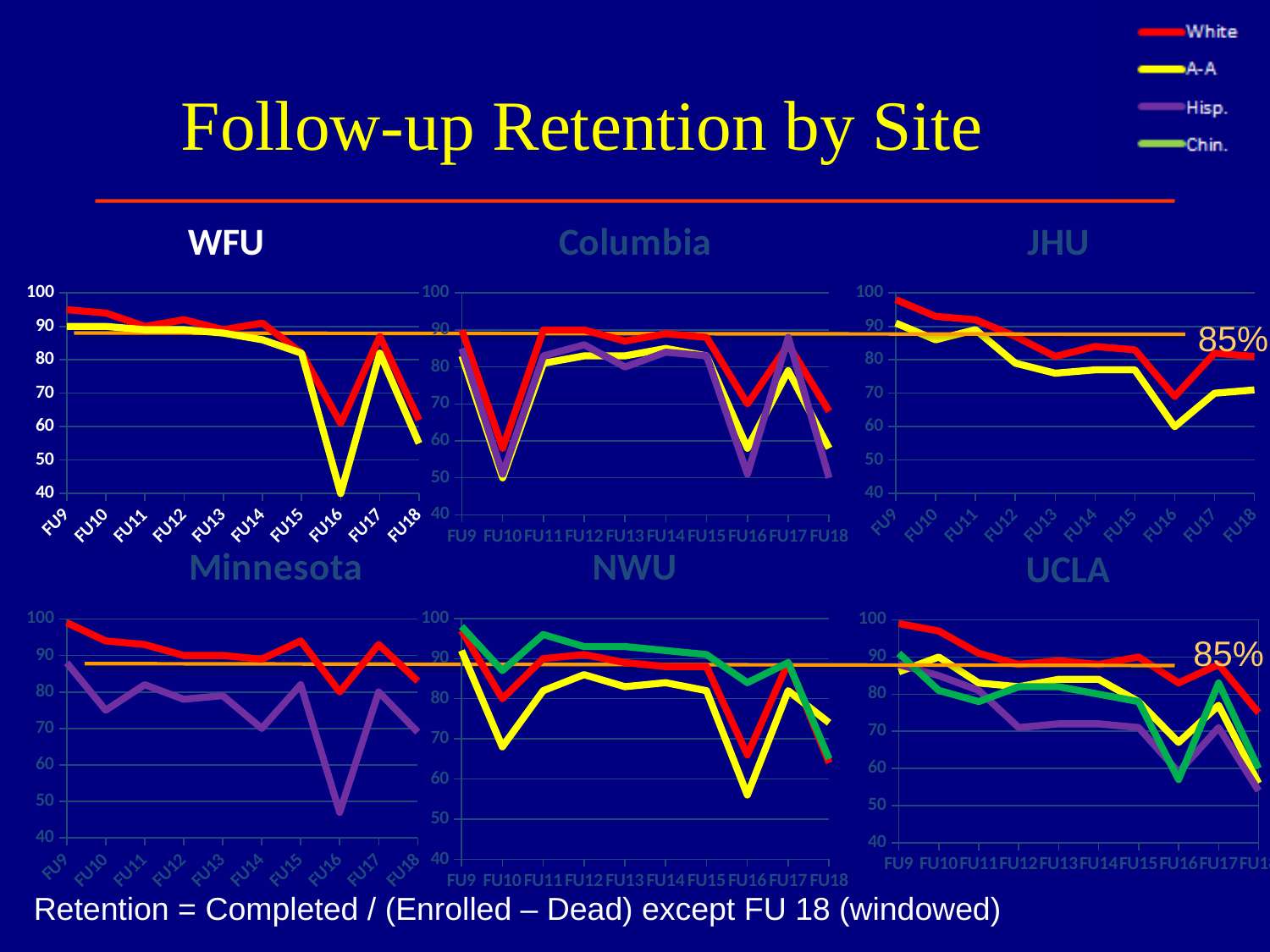
In the JHU chart, is the A-A value at FU16 greater or less than 70? less How many follow-up points (FU9 to FU18) are shown on the x axis of the WFU chart? 10 What value does the horizontal orange reference line across the charts mark? 85% In the Minnesota chart, at which follow-up does the Hisp. series reach its lowest point? FU16 What kind of chart is used for each site on the slide? line chart In the Columbia chart, is the A-A value at FU10 greater or less than 60? less In the WFU chart, is the White value at FU9 greater or less than 90? greater In the JHU chart, does the A-A series generally rise or fall from FU9 to FU18? fall How many series does the legend at the top right list? 4 In the WFU chart, at FU16 which series is higher, White or A-A? White